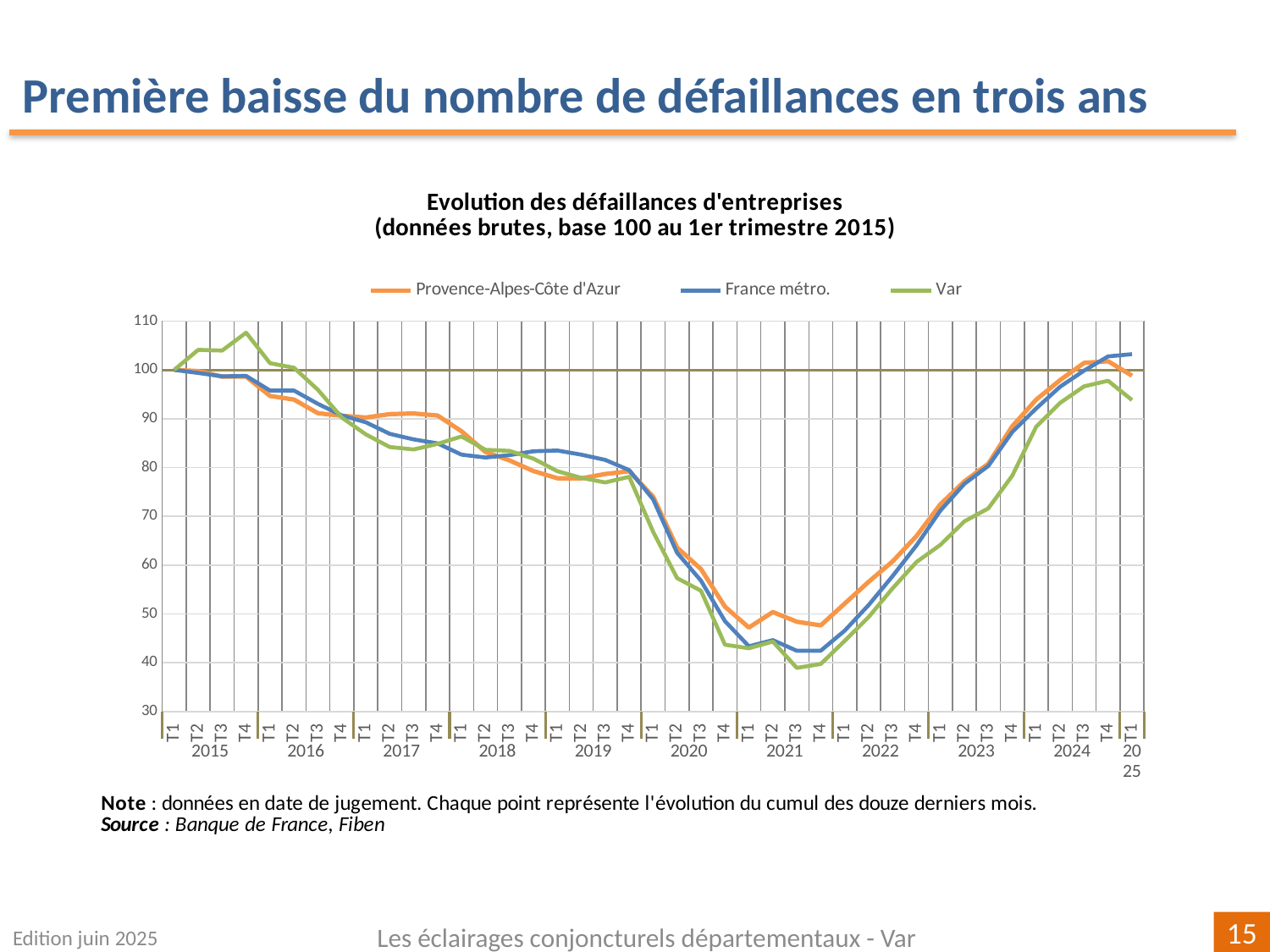
Is the value for Provence-Alpes-Côte d'Azur at T1 2021 greater or less than 50? less Is the value for France métro. at T1 2025 greater or less than 100? greater Which series reaches the lowest point on the chart? Var What is the title of the chart? Evolution des défaillances d'entreprises (données brutes, base 100 au 1er trimestre 2015) Which three series are listed in the chart legend? Provence-Alpes-Côte d'Azur, France métro., Var What kind of chart is shown on the slide? line chart At T1 2025, which is higher: France métro. or Var? France métro. Do the values for the three series rise or fall between T1 2021 and T4 2024? rise Is the value for Var at T1 2025 greater or less than 100? less How many series does the legend list? 3 What value do all three series take at T1 2015? 100